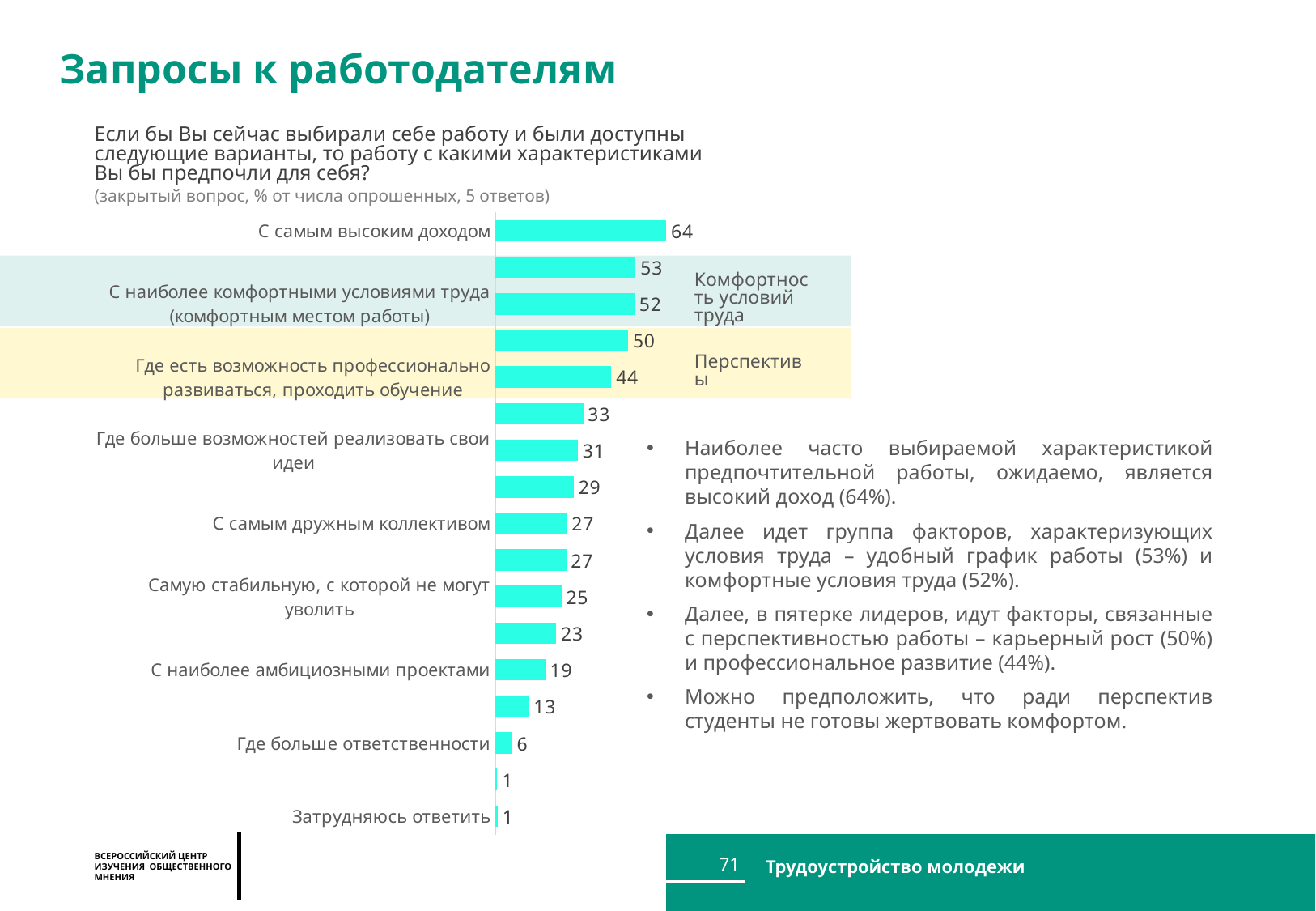
Which is larger: the value for "Самую стабильную, с которой не могут уволить" or for "Где больше возможностей реализовать свои идеи"? Где больше возможностей реализовать свои идеи What is the smallest value shown on the chart? 1 What is the value for "Где больше ответственности"? 6 What is the value for "С самым высоким доходом"? 64 Do the bar values increase or decrease from the top of the chart to the bottom? Decrease What is the value for "С наиболее комфортными условиями труда (комфортным местом работы)"? 52 What is the difference between the values for "С самым высоким доходом" and "С наиболее амбициозными проектами"? 45 What is the value for "С самым дружным коллективом"? 27 What type of chart is shown on the slide? Bar chart Which category has the highest value? С самым высоким доходом What is the value for "Где есть возможность профессионально развиваться, проходить обучение"? 44 How many bars are plotted on the chart? 17